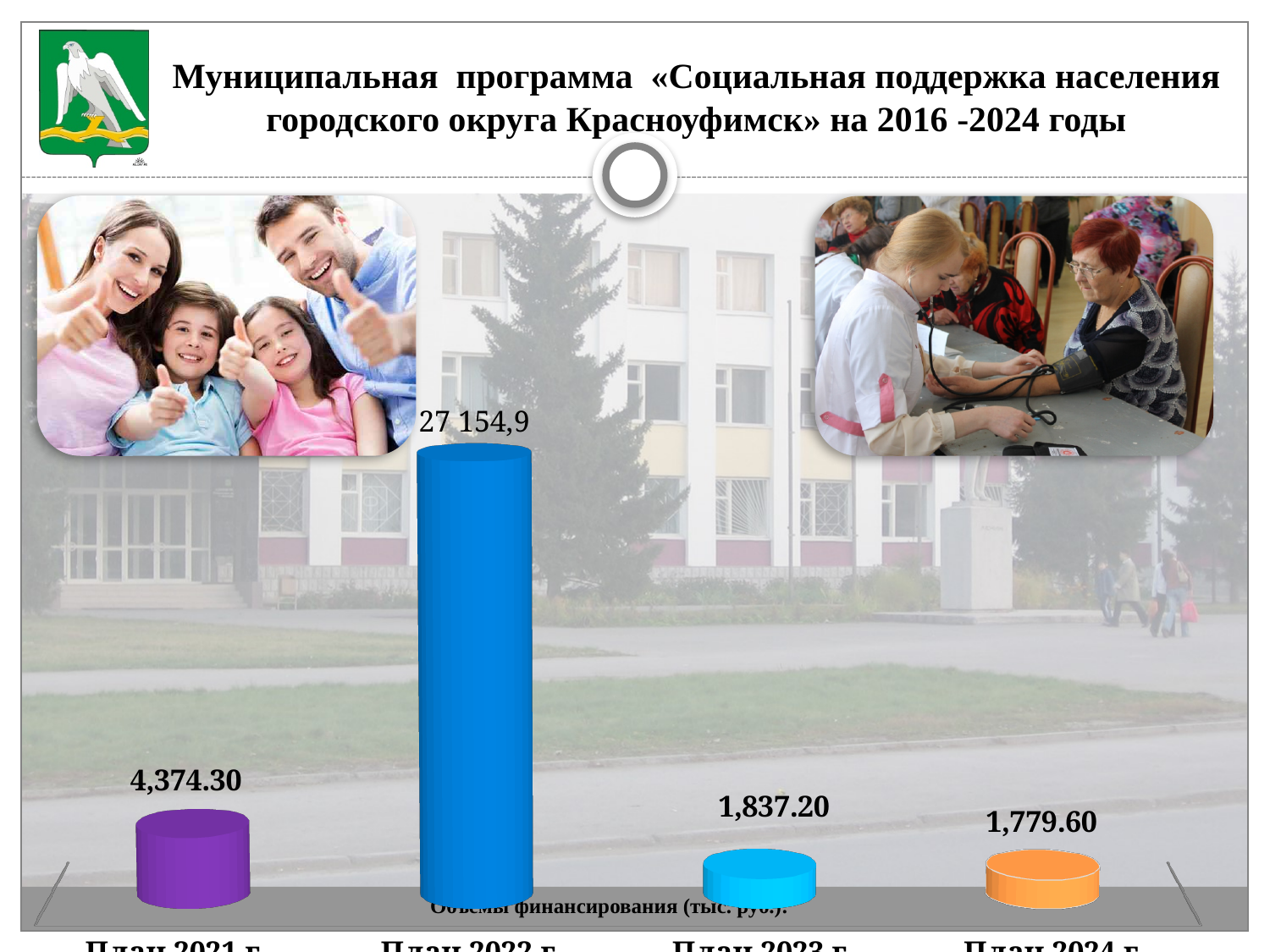
Which category has the highest value? План 2022 г. What colour is the bar for План 2024 г.? Orange What is the difference between the values for План 2021 г. and План 2023 г.? 2,537.10 What kind of chart is shown on the slide? Bar chart How many categories are plotted in the chart? 4 What is the value shown for План 2024 г.? 1,779.60 Which is larger, the value for План 2021 г. or the value for План 2023 г.? План 2021 г. What is the value shown for План 2021 г.? 4,374.30 Which category has the lowest value? План 2024 г. What is the value shown for План 2023 г.? 1,837.20 What is the value shown for План 2022 г.? 27 154,9 What is the difference between the values for План 2023 г. and План 2024 г.? 57.60